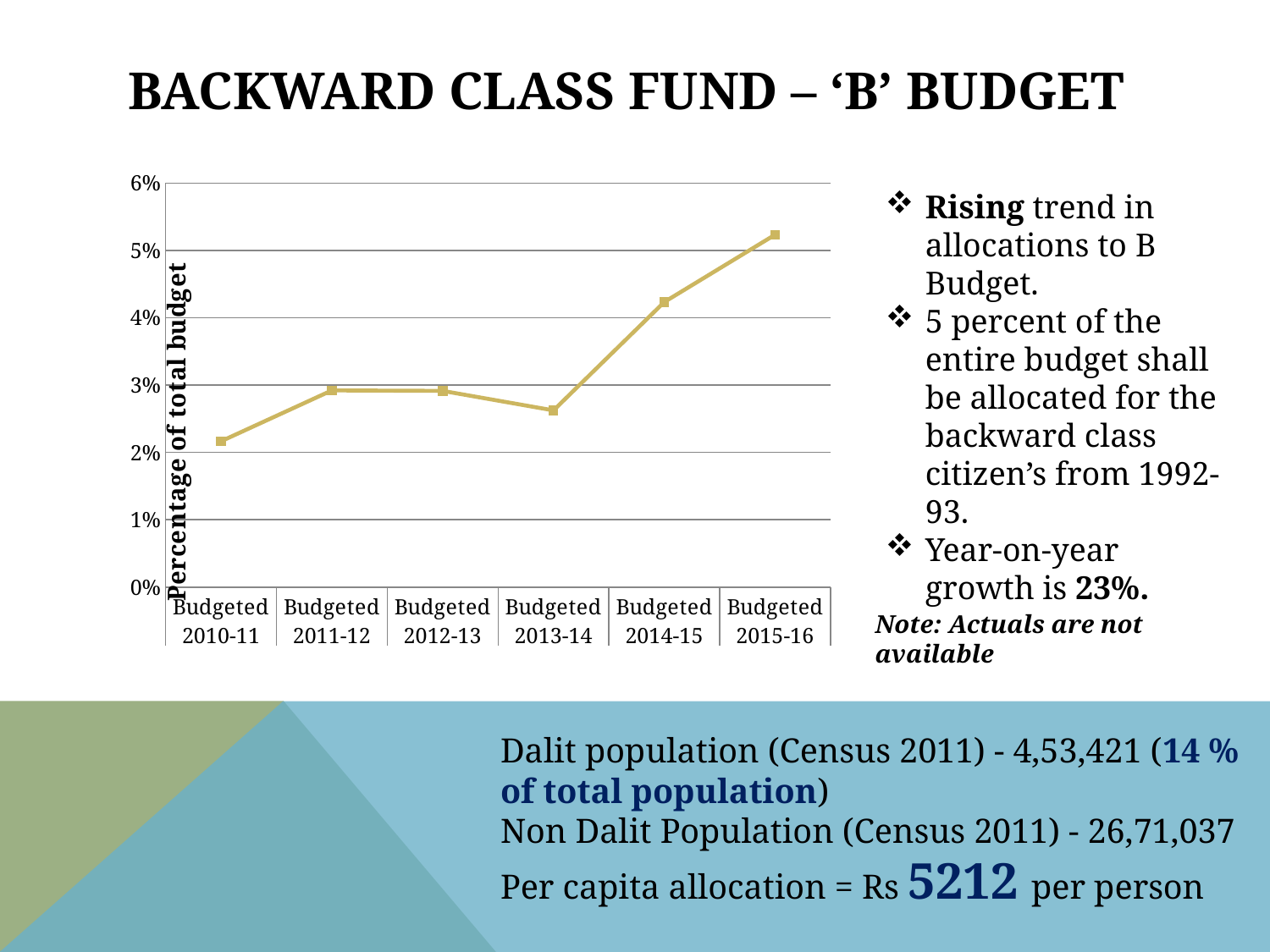
Which budget year has the highest percentage of total budget? Budgeted 2015-16 What kind of chart is shown on the slide? line chart Is the value for Budgeted 2010-11 greater or less than 2%? greater Which is larger, the value for Budgeted 2014-15 or Budgeted 2013-14? Budgeted 2014-15 How many budget years are plotted on the chart? 6 Is the value for Budgeted 2014-15 greater or less than 4%? greater Is the value for Budgeted 2014-15 greater or less than 5%? less What is the label on the vertical axis of the chart? Percentage of total budget Overall, do the values rise or fall from Budgeted 2010-11 to Budgeted 2015-16? rise Which budget year has the lowest percentage of total budget? Budgeted 2010-11